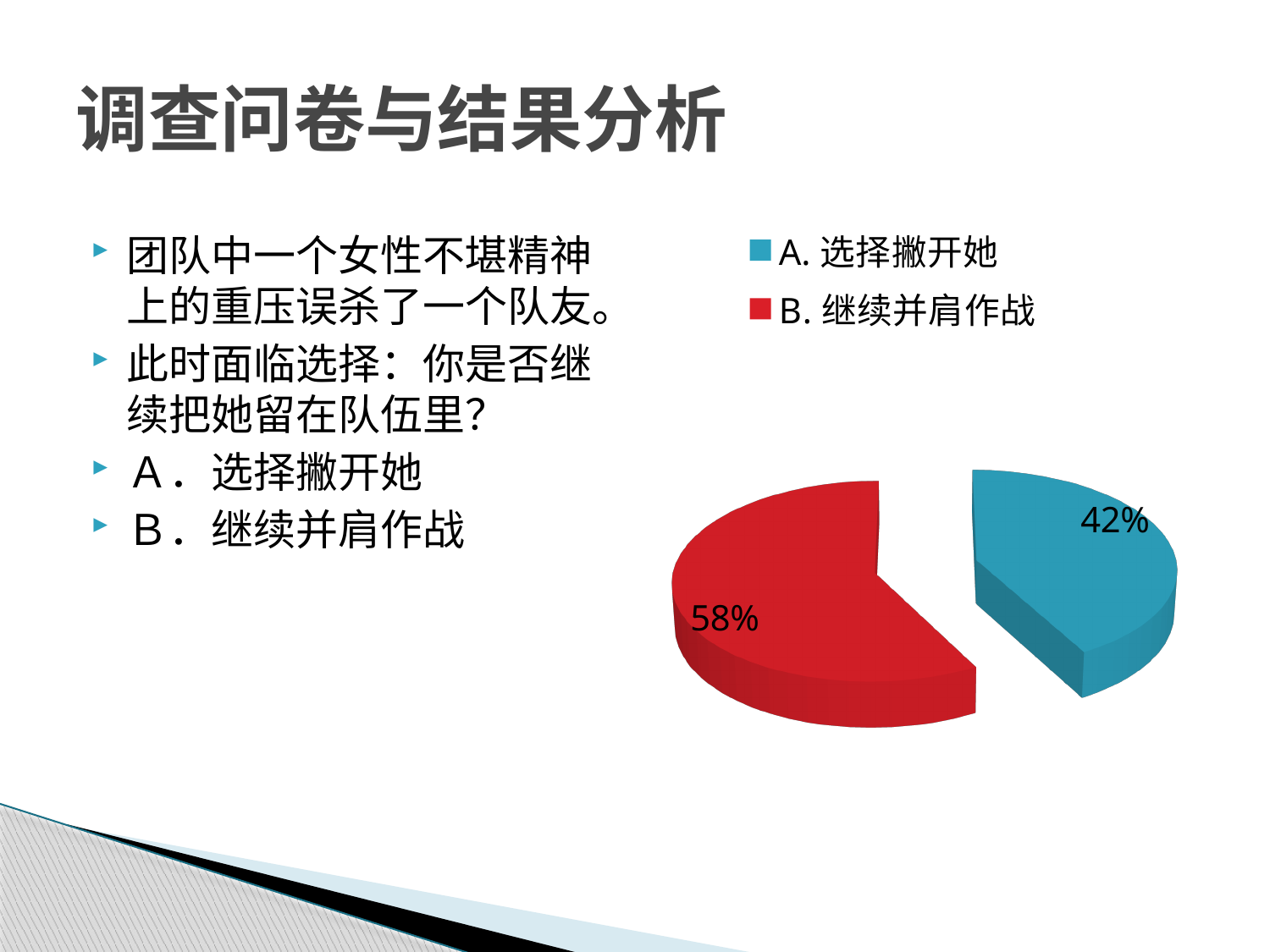
What is the difference in percentage points between "B. 继续并肩作战" and "A. 选择撇开她"? 16% What kind of chart is shown on the slide? pie chart Which is larger, the slice for "A. 选择撇开她" or the slice for "B. 继续并肩作战"? B. 继续并肩作战 Which option has the largest slice of the pie? B. 继续并肩作战 Which option has the smallest slice of the pie? A. 选择撇开她 What colour is the slice for "A. 选择撇开她"? blue How many entries does the legend list? 2 What share of the pie does "B. 继续并肩作战" represent? 58% How many slices does the pie chart have? 2 What share of the pie does "A. 选择撇开她" represent? 42% What colour is the slice for "B. 继续并肩作战"? red